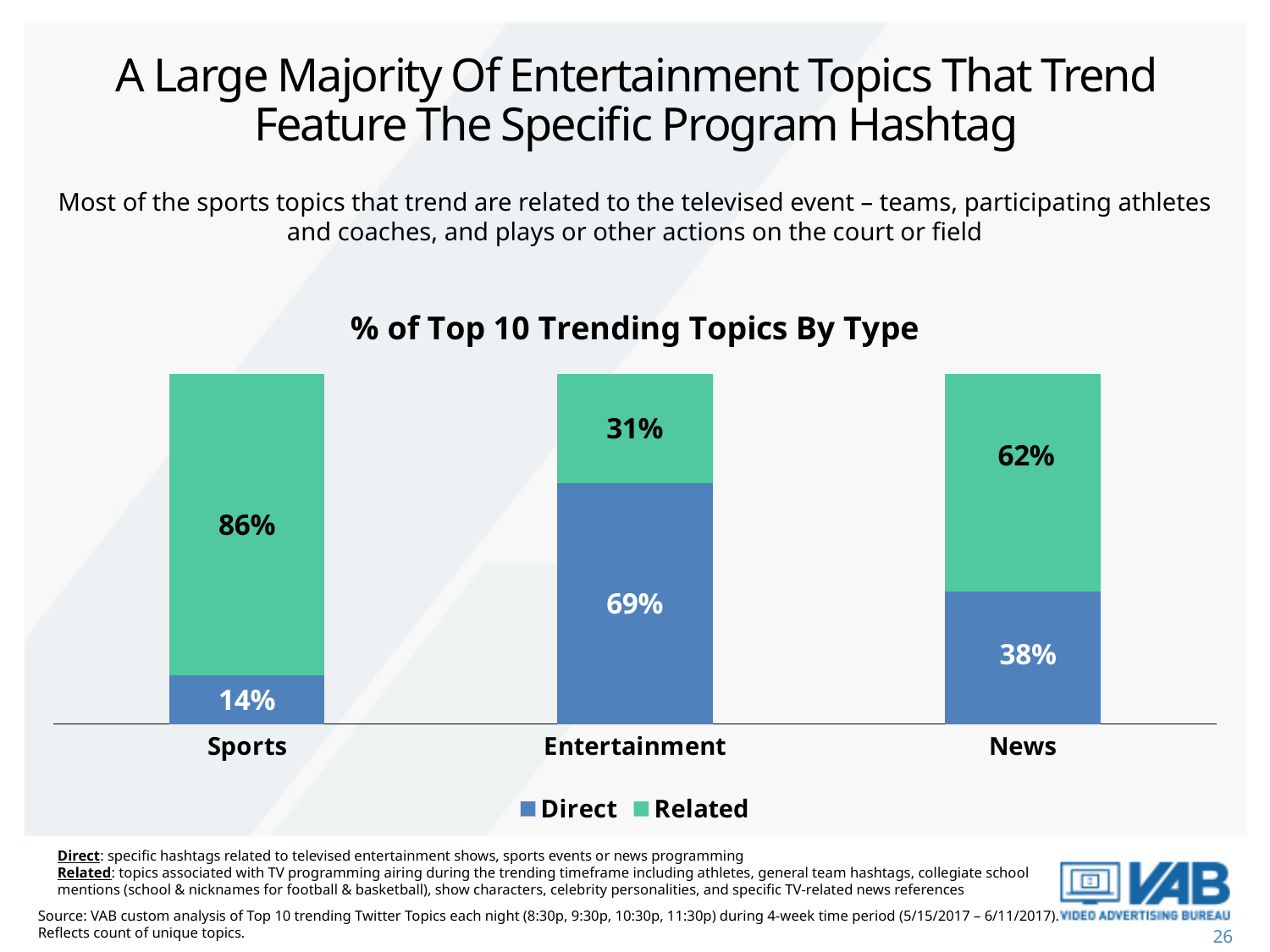
Which category has the lowest Related value? Entertainment How many categories are shown on the x axis? 3 What is the difference between the Related value for Sports and the Related value for News? 24% What is the Direct value for News? 38% What is the Related value for Entertainment? 31% Which category has the highest Direct value? Entertainment How many series does the legend list? 2 What is the title of the chart? % of Top 10 Trending Topics By Type What kind of chart is shown? Stacked bar chart What is the Direct value for Sports? 14% Is the Direct value larger for Entertainment or for News? Entertainment What is the Related value for Sports? 86%